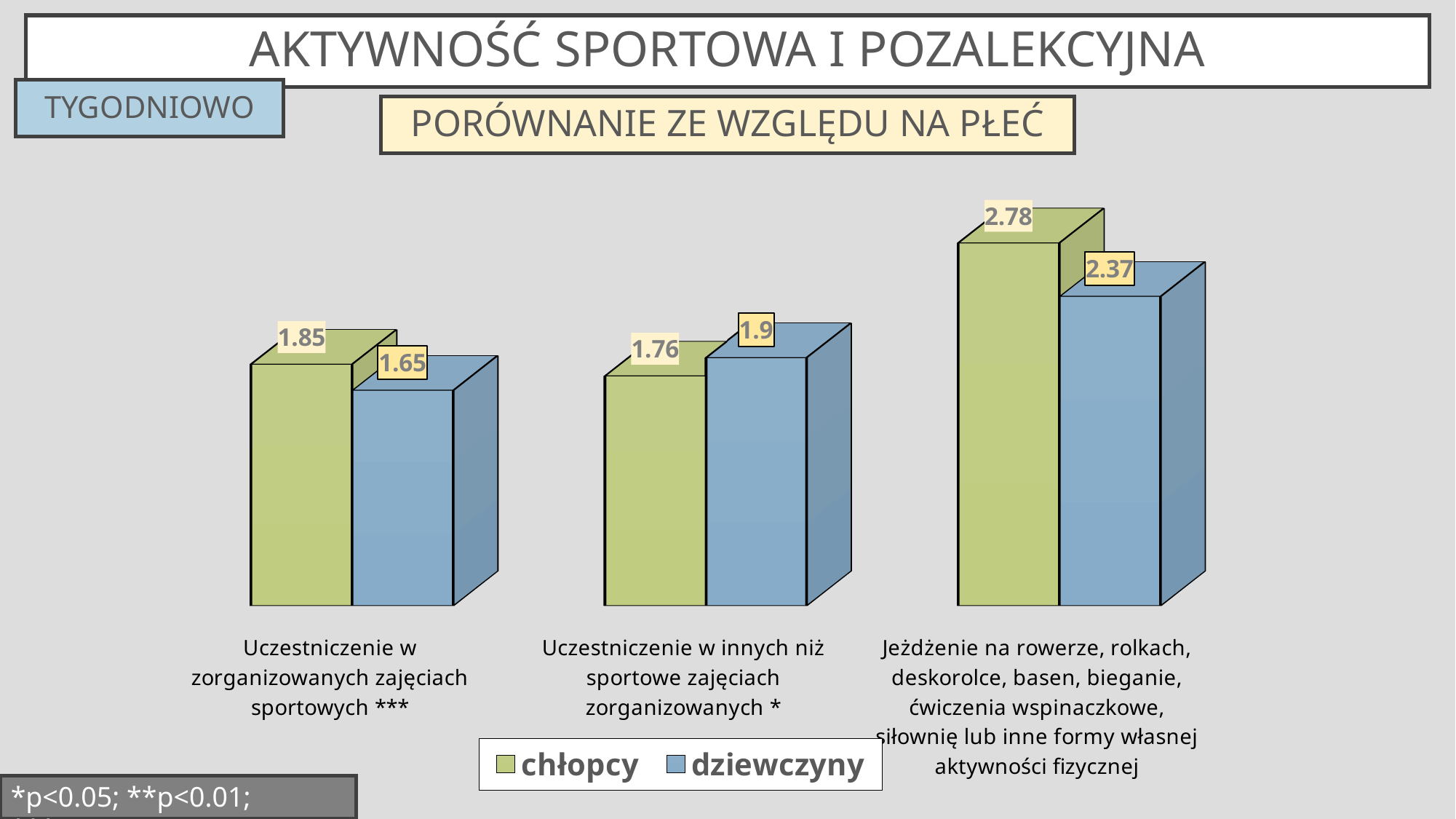
What is the value for dziewczyny in the category 'Uczestniczenie w innych niż sportowe zajęciach zorganizowanych *'? 1.9 Which category has the lowest value for dziewczyny? Uczestniczenie w zorganizowanych zajęciach sportowych *** What is the value for chłopcy in the category 'Uczestniczenie w zorganizowanych zajęciach sportowych ***'? 1.85 What is the difference between chłopcy and dziewczyny in the category 'Uczestniczenie w zorganizowanych zajęciach sportowych ***'? 0.2 Which colour represents the series 'chłopcy' in the chart? green What kind of chart is shown on the slide? bar chart How many series does the chart legend list? 2 How many categories are shown on the x axis of the chart? 3 What is the difference between chłopcy and dziewczyny in the category 'Jeżdżenie na rowerze, rolkach, deskorolce, basen, bieganie, ćwiczenia wspinaczkowe, siłownię lub inne formy własnej aktywności fizycznej'? 0.41 Which category has the highest value for chłopcy? Jeżdżenie na rowerze, rolkach, deskorolce, basen, bieganie, ćwiczenia wspinaczkowe, siłownię lub inne formy własnej aktywności fizycznej In the category 'Uczestniczenie w innych niż sportowe zajęciach zorganizowanych *', which series has the larger value, chłopcy or dziewczyny? dziewczyny What is the value for dziewczyny in the category 'Jeżdżenie na rowerze, rolkach, deskorolce, basen, bieganie, ćwiczenia wspinaczkowe, siłownię lub inne formy własnej aktywności fizycznej'? 2.37